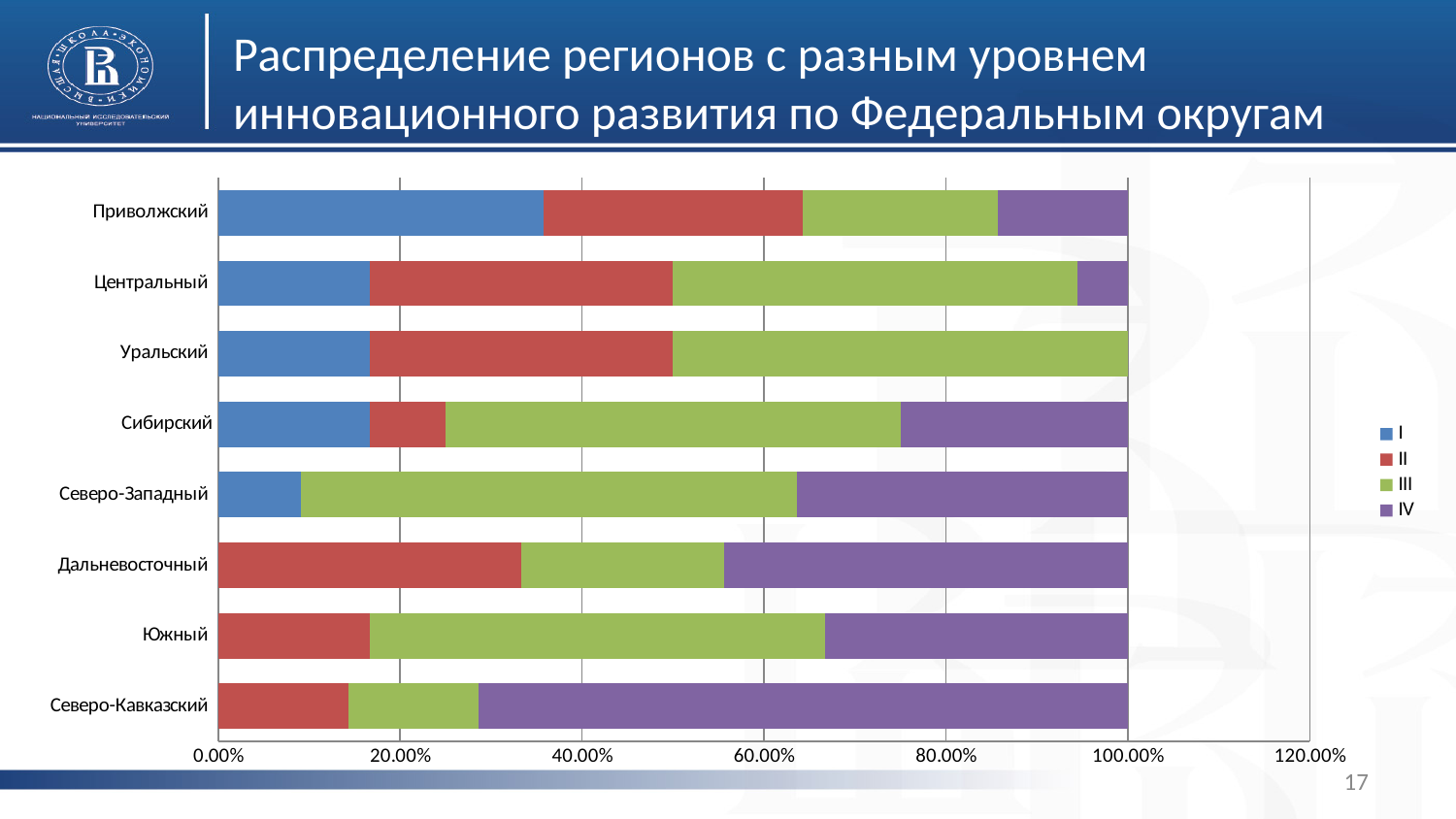
Which federal district has the largest series IV segment? Северо-Кавказский What is the total of the stacked bar for Приволжский? 100.00% What kind of chart is shown on the slide? Stacked bar chart Which federal district has the largest series I segment? Приволжский Which series is shown in purple? IV How many federal districts (categories) are shown on the chart? 8 Which federal district has no series IV segment? Уральский Is the series IV value for Северо-Кавказский greater or less than 60%? greater What are the series names listed in the legend? I, II, III, IV Which is larger, the series I segment for Приволжский or for Центральный? Приволжский Is the series I value for Северо-Западный greater or less than 20%? less How many series does the legend list? 4